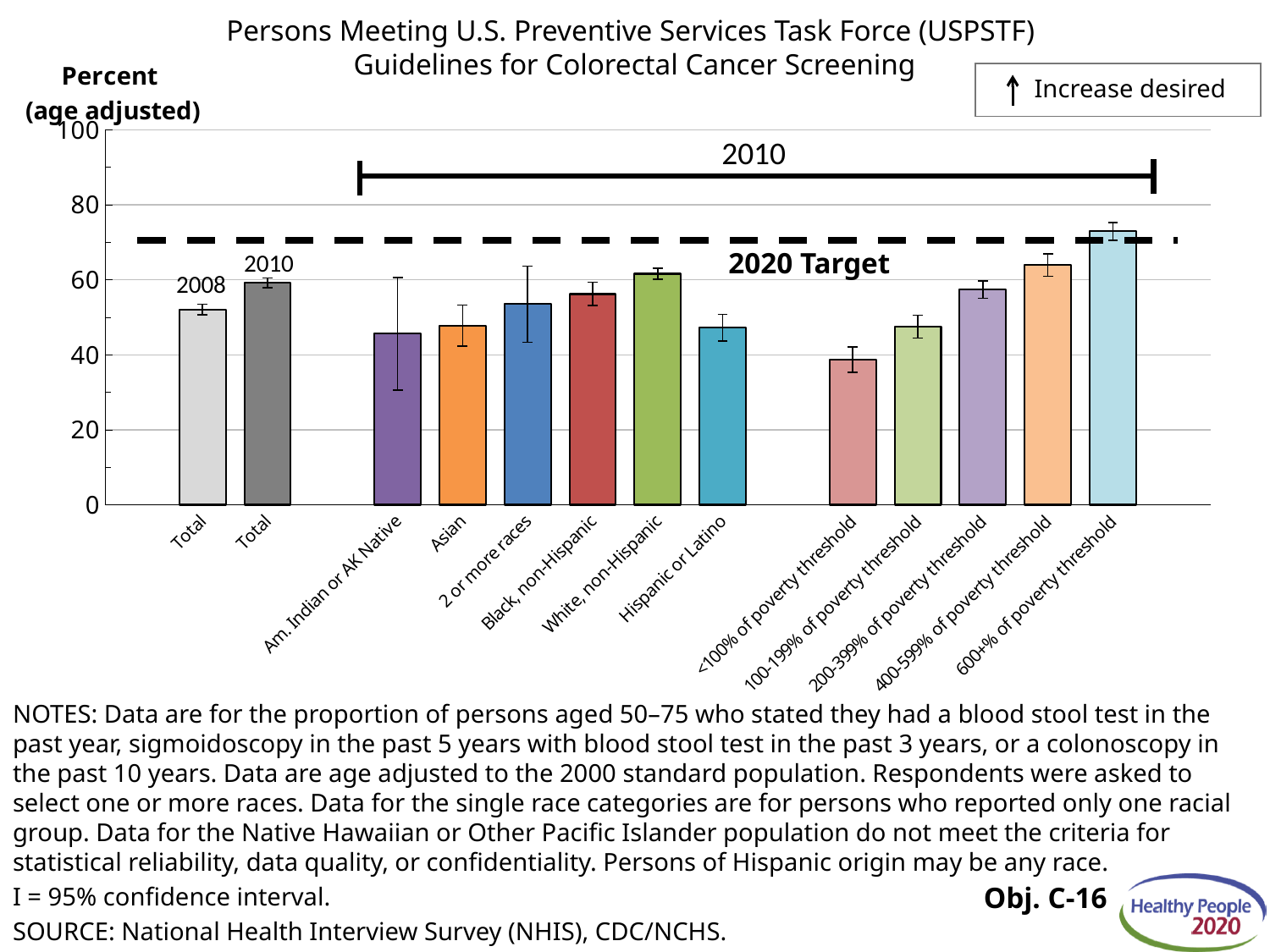
Which is larger, the value for White, non-Hispanic or for Hispanic or Latino? White, non-Hispanic What kind of chart is shown on the slide? bar chart Which category has the lowest bar? <100% of poverty threshold What does the horizontal dashed line on the chart represent? 2020 Target Is the value for the 2008 Total greater or less than 40? greater Is the value for Am. Indian or AK Native greater or less than 60? less Which is larger, the Total for 2008 or the Total for 2010? 2010 Which category has the highest bar? 600+% of poverty threshold How many bars are plotted on the chart? 13 Is the value for 600+% of poverty threshold greater or less than 60? greater Which is larger, the value for Black, non-Hispanic or for Asian? Black, non-Hispanic